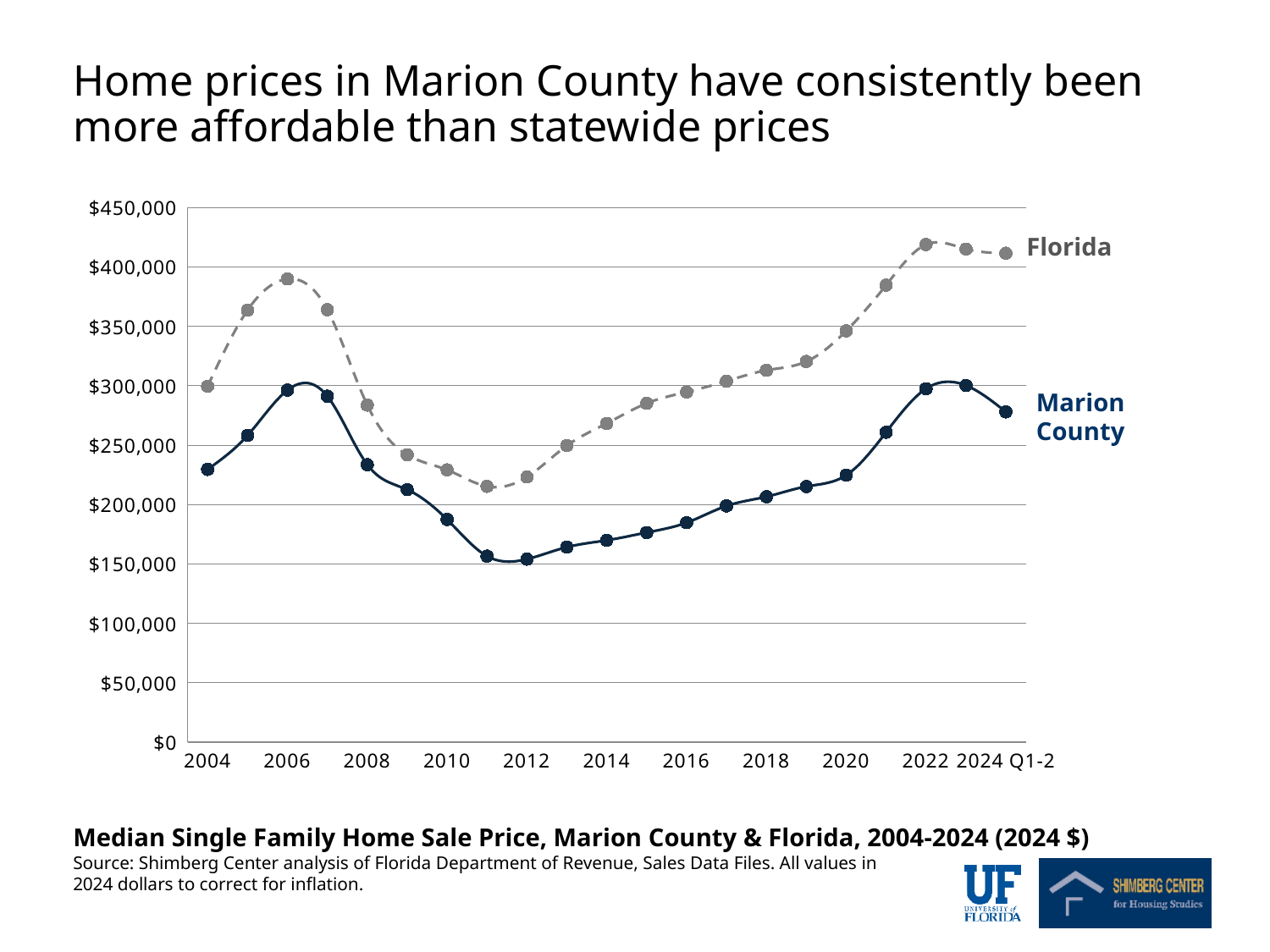
How many series are plotted on the chart? 2 What kind of chart is shown on the slide? Line chart In 2006, which series has the higher value, Florida or Marion County? Florida Is the Florida value for 2006 greater or less than $350,000? greater Is the Florida value for 2022 greater or less than $400,000? greater Is the Marion County value for 2020 greater or less than $200,000? greater Which series is drawn with a dashed line? Florida How many data points does the Marion County line have? 21 Does the Florida line rise or fall between 2006 and 2011? Fall Does the Marion County line rise or fall between 2012 and 2022? Rise